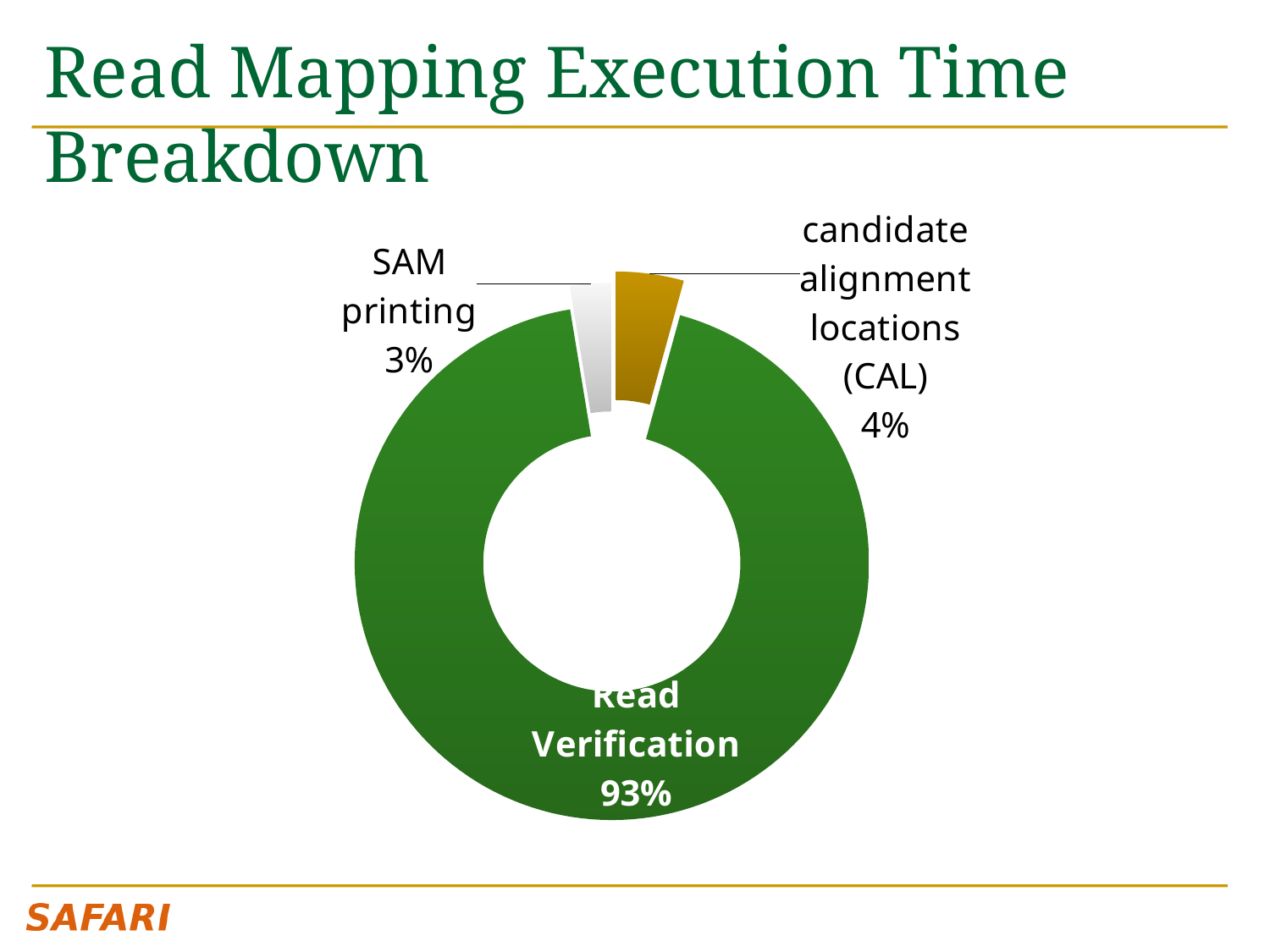
Which takes a larger share of execution time, SAM printing or candidate alignment locations (CAL)? candidate alignment locations (CAL) What colour is the Read Verification segment? Green What is the difference in percentage points between Read Verification and candidate alignment locations (CAL)? 89 Which stage takes the smallest share of read mapping execution time? SAM printing What kind of chart is shown on the slide? Doughnut (pie) chart What is the difference in percentage points between candidate alignment locations (CAL) and SAM printing? 1 What share of read mapping execution time is taken by Read Verification? 93% What share of execution time is taken by candidate alignment locations (CAL)? 4% What share of execution time is taken by SAM printing? 3% Which stage takes the largest share of read mapping execution time? Read Verification How many stages are shown in the chart? 3 What is the title of the slide? Read Mapping Execution Time Breakdown